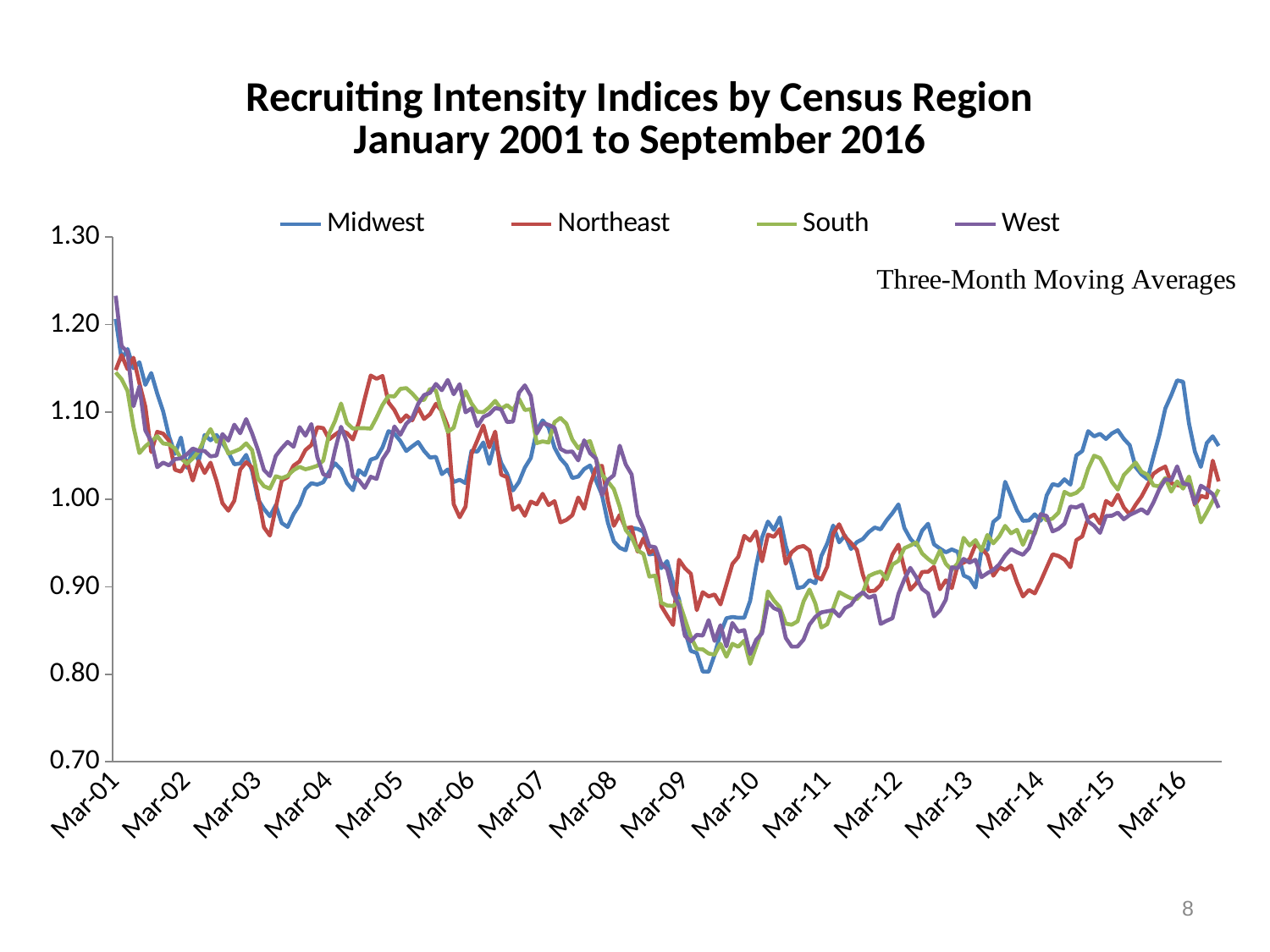
Is the value for Midwest at Mar-01 greater or less than 1.10? greater How many series does the legend list? 4 Which four regions are listed in the legend? Midwest, Northeast, South, West Is the value for Northeast at Mar-14 greater or less than 1.00? less What kind of chart is shown on the slide? line chart Is the value for Northeast at Mar-01 greater or less than 1.10? greater Do the Midwest values generally rise or fall from Mar-01 to Mar-10? fall What note appears in the upper right of the plot area? Three-Month Moving Averages